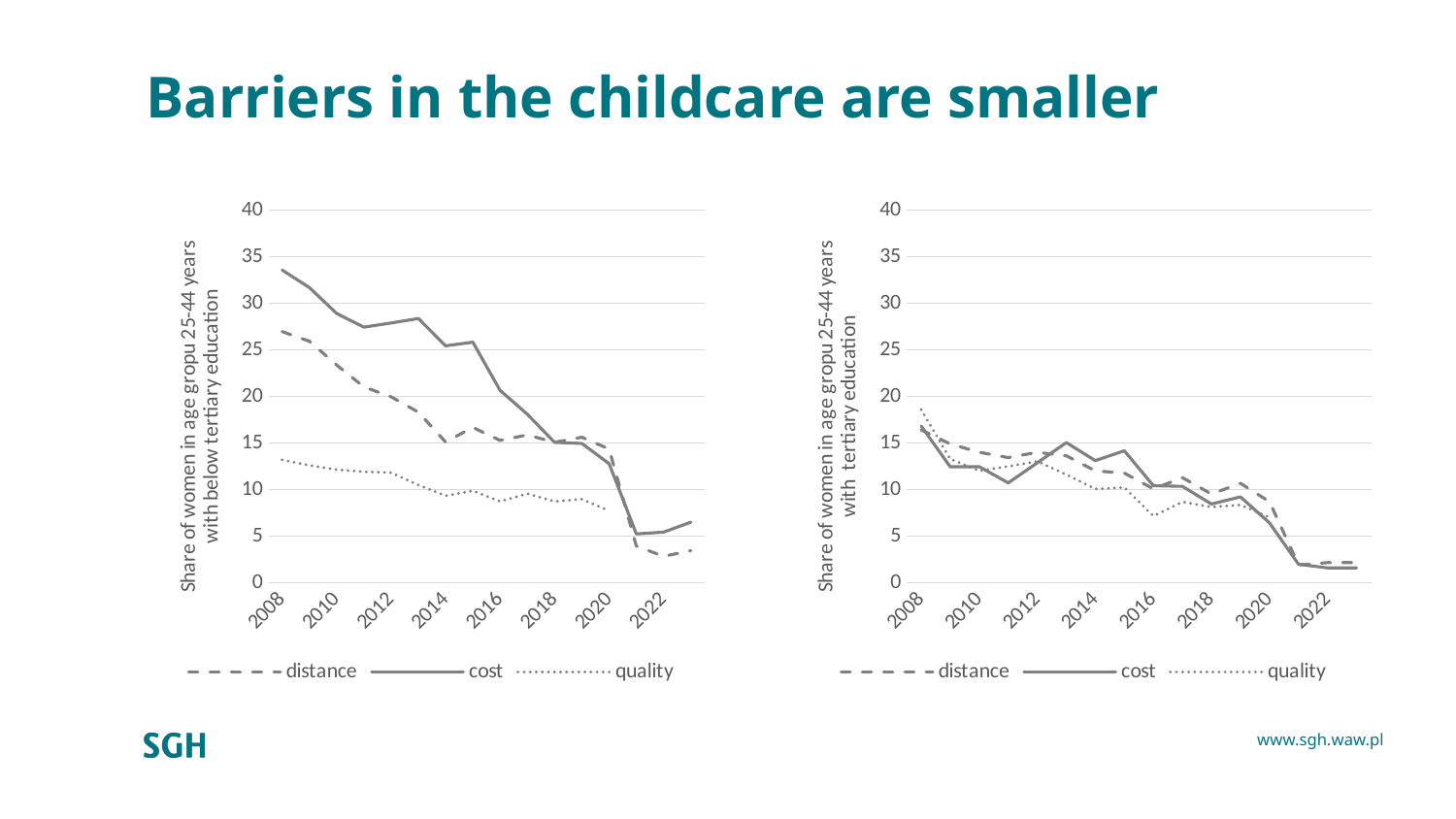
In the right chart (tertiary education), does the distance series generally rise or fall from 2008 to 2022? fall In the left chart (below tertiary education), is the value for distance in 2022 greater or less than 5? less In the right chart (tertiary education), which is larger in 2016: cost or quality? cost Which series is drawn with a dashed line in the left chart's legend? distance What kind of chart is the left chart on the slide? line chart In the left chart (below tertiary education), does the cost series generally rise or fall from 2008 to 2022? fall In the left chart (below tertiary education), which series has the highest value in 2008? cost How many series does the legend of the right chart list? 3 In the left chart (below tertiary education), is the value for cost in 2008 greater or less than 30? greater In the right chart (tertiary education), is the value for cost in 2022 greater or less than 5? less